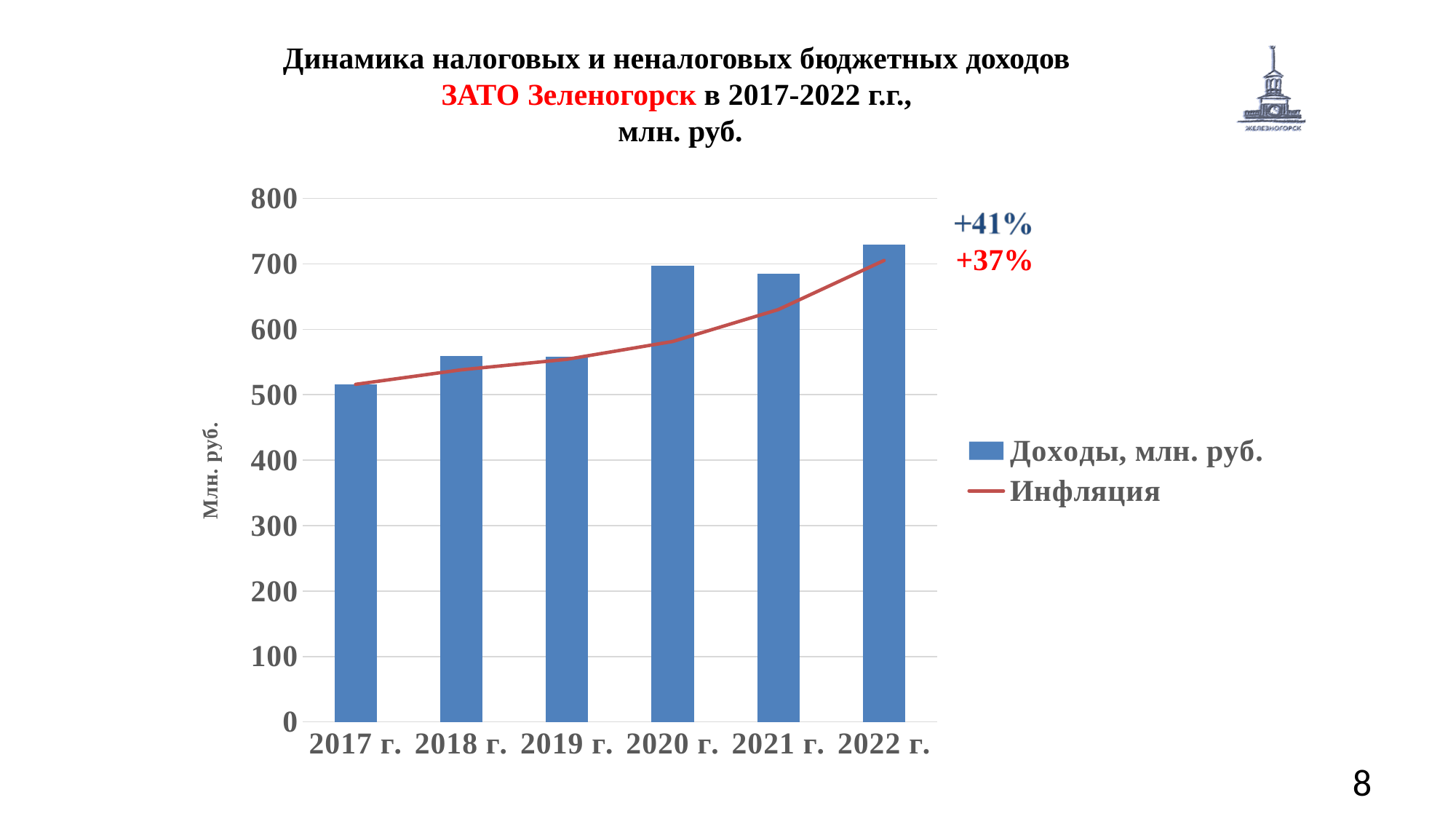
How many series does the chart legend list? 2 Which is larger, the Доходы value for 2017 г. or for 2022 г.? 2022 г. How many years are shown on the x axis of the chart? 6 Is the value for Доходы in 2017 г. greater or less than 600? less What are the two entries listed in the chart legend? Доходы, млн. руб. and Инфляция Is the value for Доходы in 2018 г. greater or less than 500? greater Is the value for Доходы in 2020 г. greater or less than 600? greater Do the Доходы values generally rise or fall from 2017 г. to 2022 г.? rise Which year has the highest value for Доходы, млн. руб.? 2022 г. Which year has the lowest value for Доходы, млн. руб.? 2017 г. What kind of chart is shown on the slide? bar and line chart (combination chart)